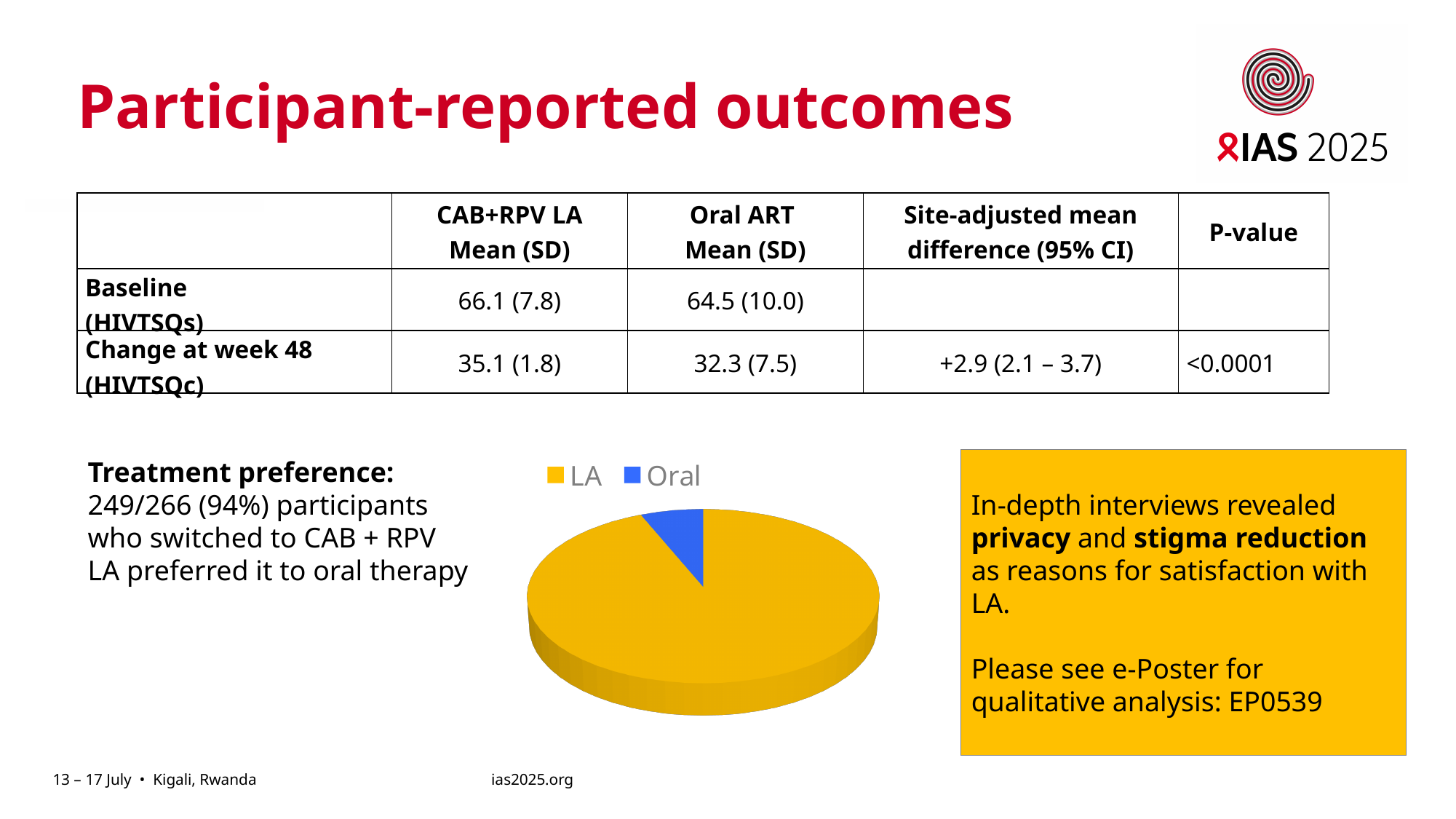
How many entries does the pie chart's legend list? 2 Which slice of the pie chart is the largest? LA Which slice of the pie chart is the smallest? Oral How many slices does the pie chart have? 2 What are the two legend entries of the pie chart? LA and Oral In the pie chart, which is larger, the LA slice or the Oral slice? LA What colour is the LA slice in the pie chart? yellow What kind of chart is shown on the slide? pie chart What share of the pie chart does the LA slice represent, according to the slide? 94%